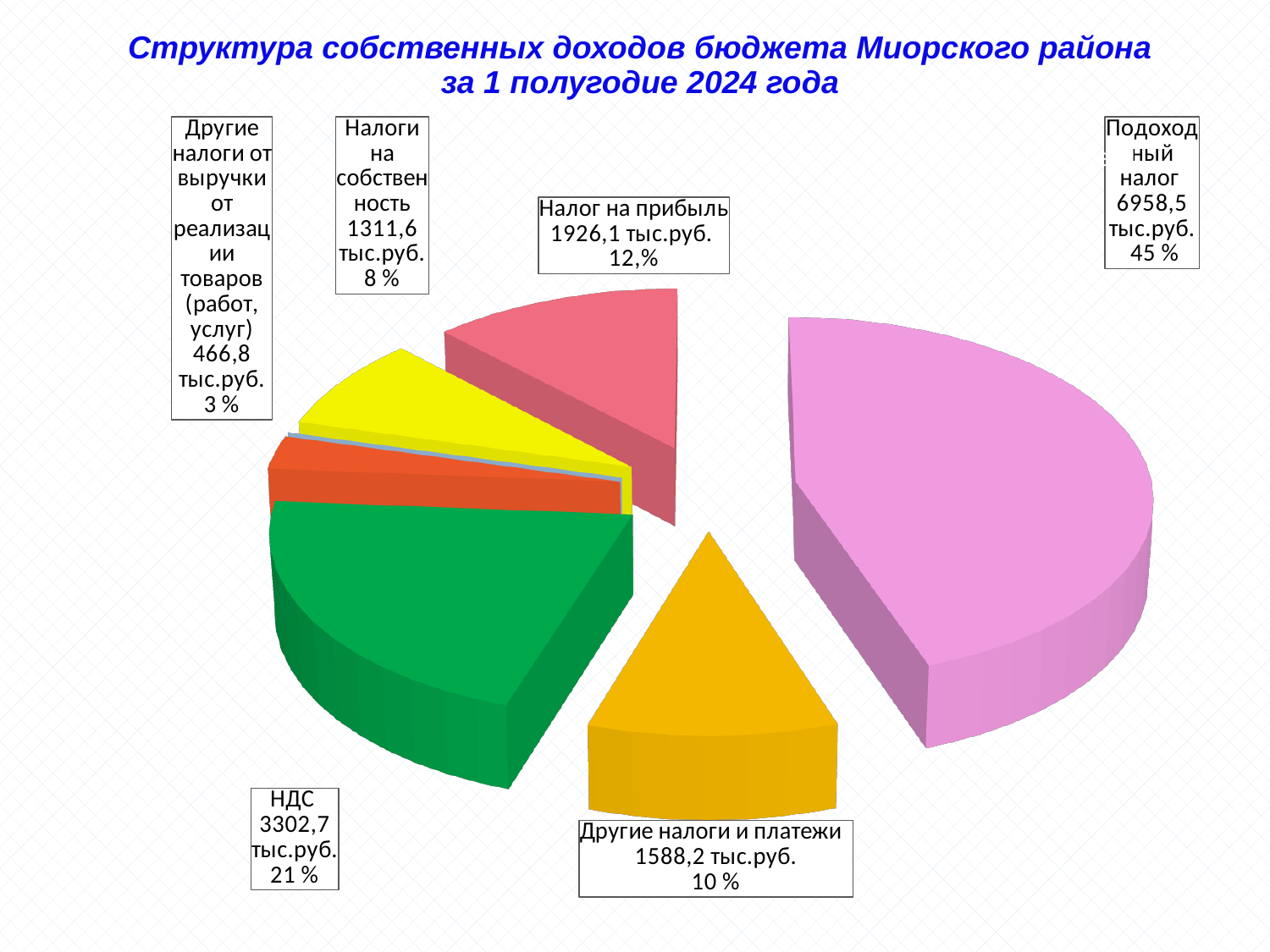
What kind of chart is shown on the slide? pie chart What is the value for Подоходный налог? 6958,5 тыс.руб. What is the value for НДС? 3302,7 тыс.руб. Which category has the largest slice of the pie? Подоходный налог What is the value for Другие налоги и платежи? 1588,2 тыс.руб. What share of the pie does Подоходный налог account for? 45 % Which is larger, Налог на прибыль or Налоги на собственность? Налог на прибыль What is the difference between Подоходный налог and НДС? 3655,8 тыс.руб. What share of the pie does НДС account for? 21 % What is the value for Налог на прибыль? 1926,1 тыс.руб.